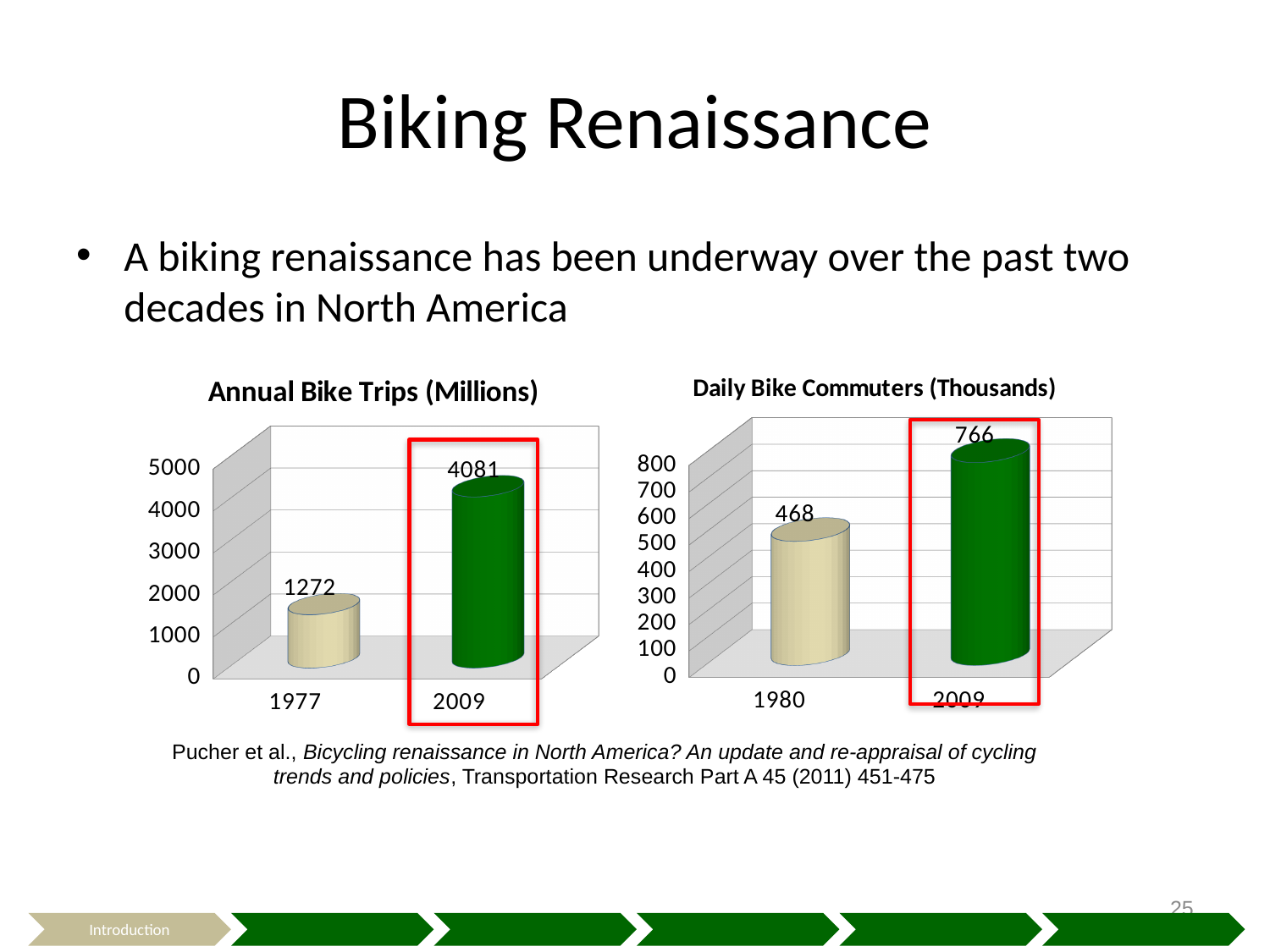
In the 'Annual Bike Trips (Millions)' chart, do the values rise or fall from 1977 to 2009? rise In the 'Daily Bike Commuters (Thousands)' chart, what is the value for 2009? 766 In the 'Daily Bike Commuters (Thousands)' chart, is the value for 1980 greater or less than 500? less In the 'Daily Bike Commuters (Thousands)' chart, what is the value for 1980? 468 In the 'Annual Bike Trips (Millions)' chart, what is the value for 2009? 4081 In the 'Annual Bike Trips (Millions)' chart, what is the difference between the 2009 and 1977 values? 2809 What kind of chart is the 'Daily Bike Commuters (Thousands)' chart? bar chart In the 'Annual Bike Trips (Millions)' chart, what is the value for 1977? 1272 In the 'Daily Bike Commuters (Thousands)' chart, what is the difference between the 2009 and 1980 values? 298 In the 'Annual Bike Trips (Millions)' chart, which year has the higher value? 2009 How many categories are shown in the 'Annual Bike Trips (Millions)' chart? 2 In the 'Daily Bike Commuters (Thousands)' chart, which year has the lower value? 1980